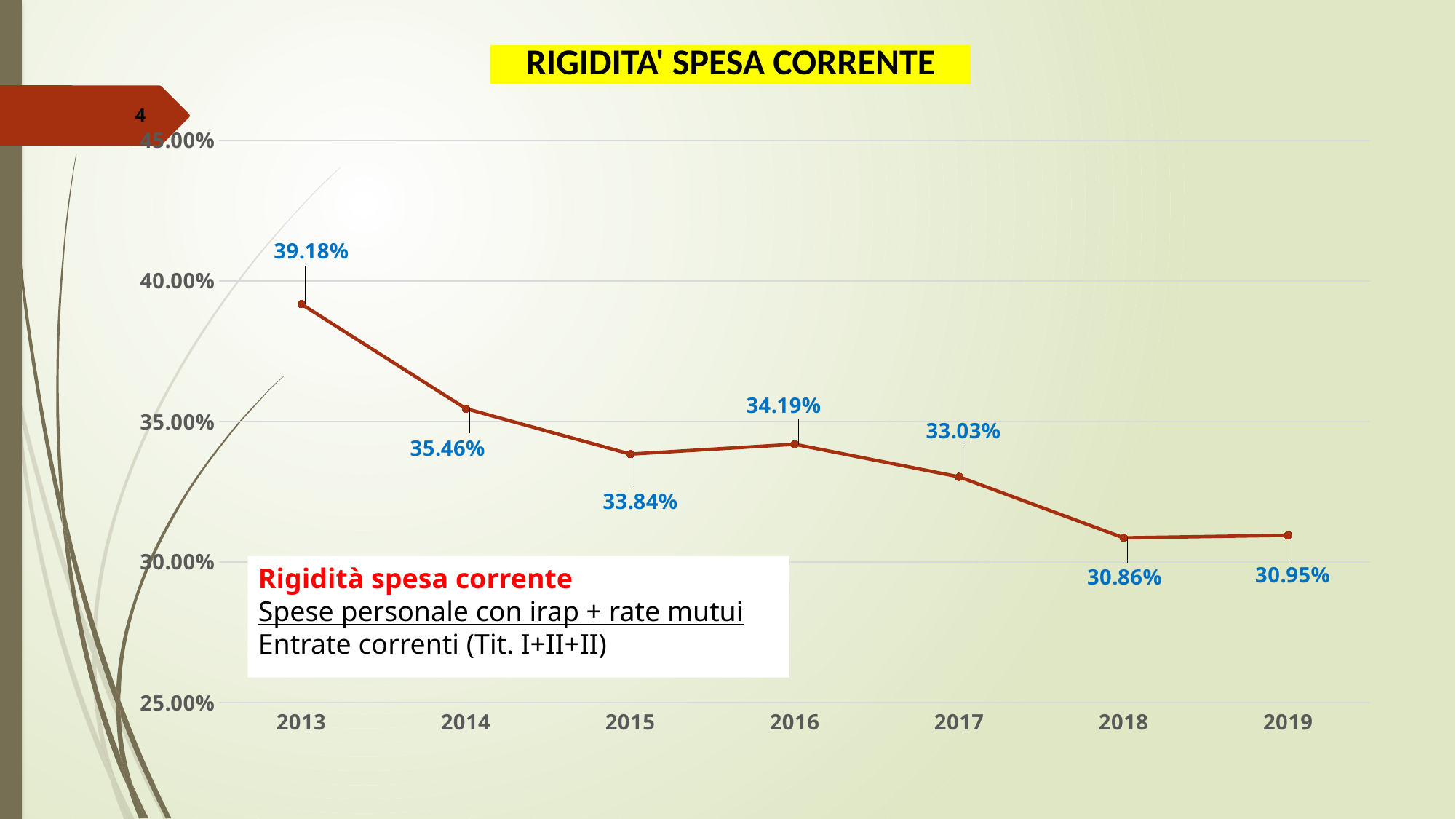
What kind of chart is shown on the slide? line chart How many years are plotted on the chart? 7 What is the title of the chart? RIGIDITA' SPESA CORRENTE What is the value for 2016? 34.19% What is the value for 2019? 30.95% Do the values generally rise or fall from 2013 to 2019? fall What is the value for 2013? 39.18% Is the value for 2017 greater or less than 35.00%? less Which year has the highest value? 2013 Which year has the lowest value? 2018 Which is larger, the value for 2015 or the value for 2016? 2016 What is the difference between the values for 2013 and 2014? 3.72%